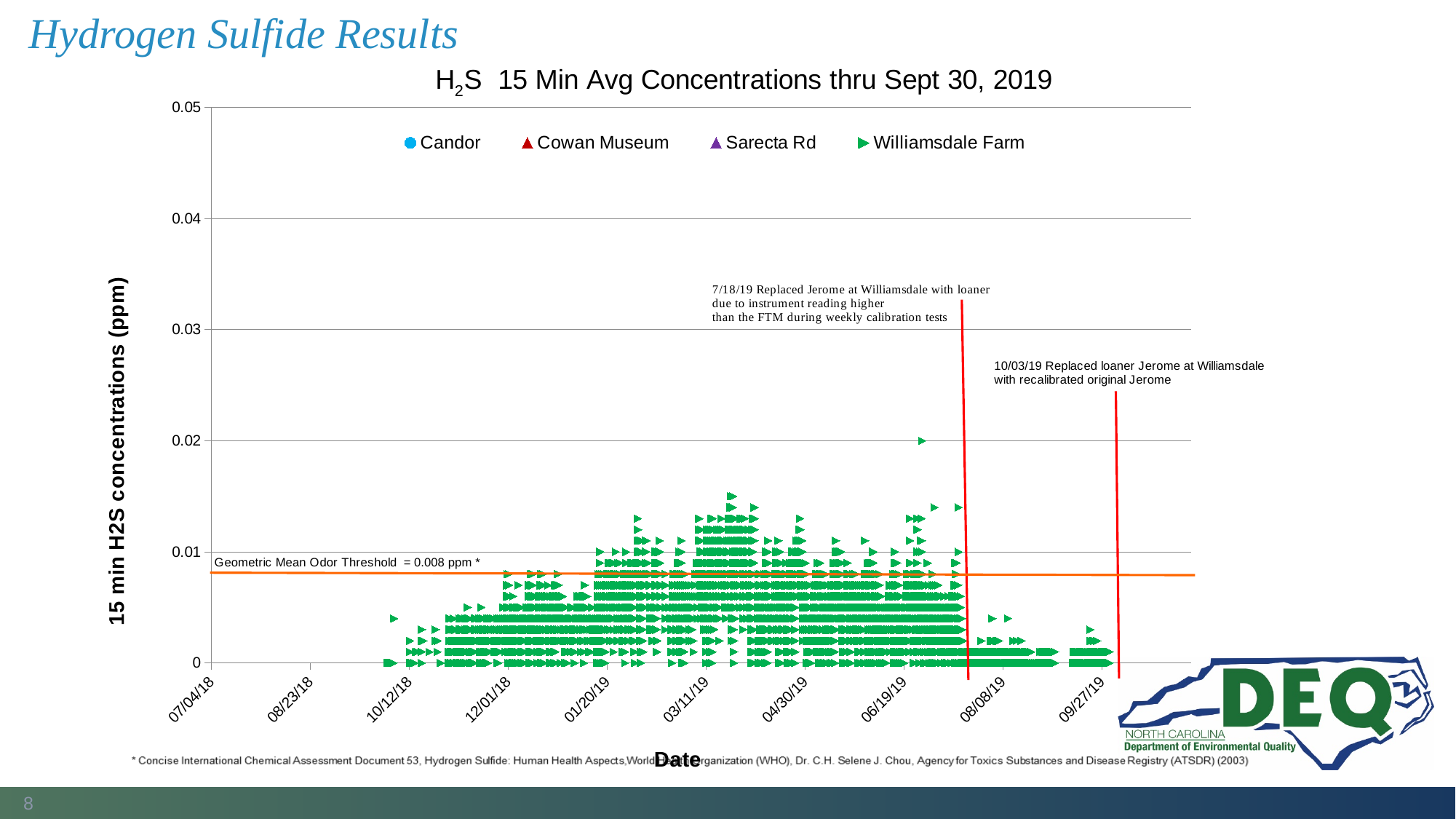
Which series in the legend is plotted with green triangle markers? Williamsdale Farm Is the highest Williamsdale Farm value plotted greater or less than 0.01? greater What is the title of the chart? H2S 15 Min Avg Concentrations thru Sept 30, 2019 What value is given for the Geometric Mean Odor Threshold shown as the orange line? 0.008 ppm Are the Williamsdale Farm values plotted after 08/08/19 generally higher or lower than those plotted around 03/11/19? lower What kind of chart is shown on the slide? scatter chart Is the highest Williamsdale Farm value plotted greater or less than 0.03? less What is the maximum value shown on the y axis? 0.05 How many series does the legend list? 4 What is the label of the y axis? 15 min H2S concentrations (ppm) On what date was the Jerome at Williamsdale replaced with a loaner, according to the annotation? 7/18/19 How many date tick labels are shown on the x axis? 10